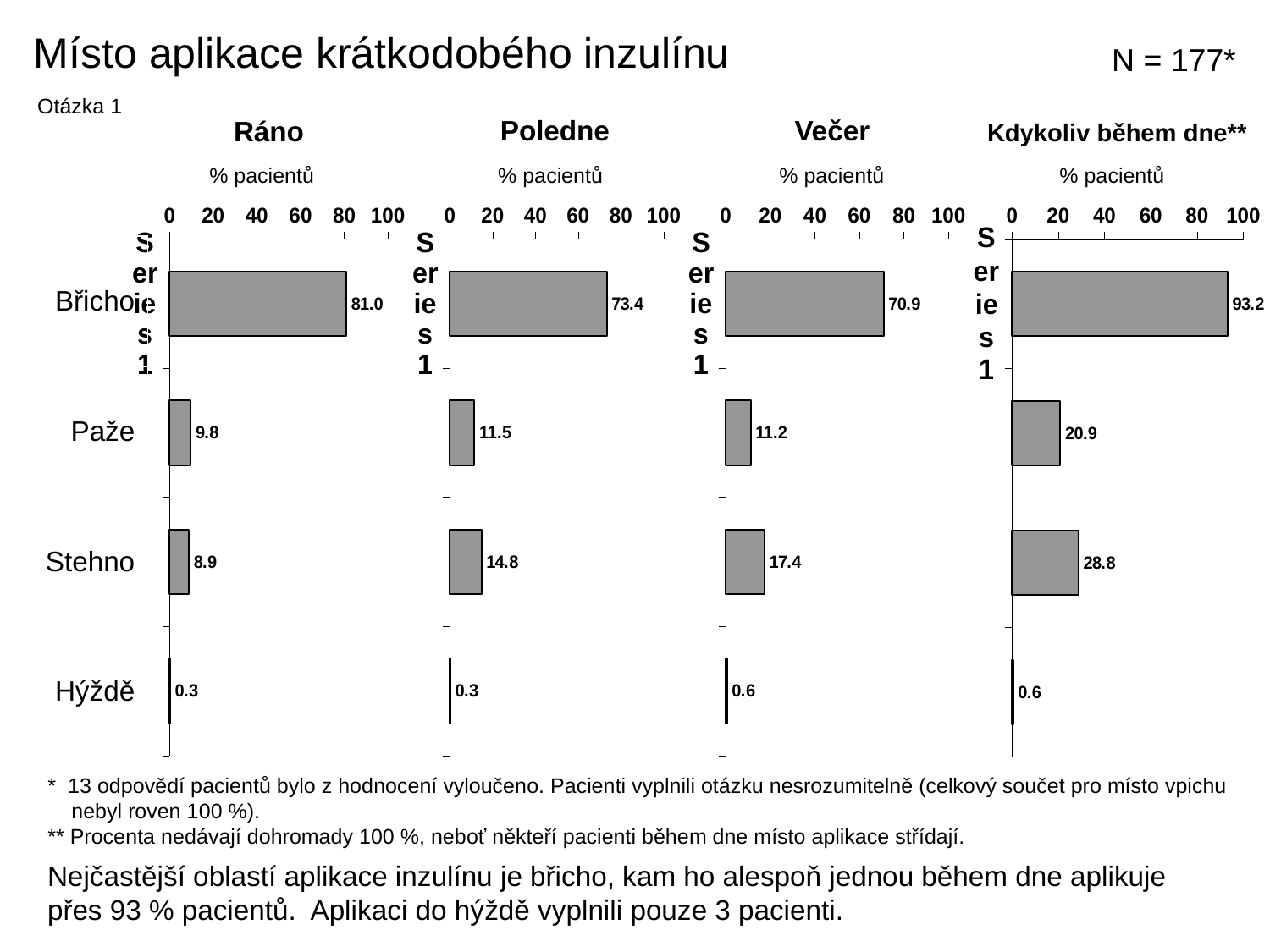
In the Poledne chart, which is larger, the value for Paže or the value for Stehno? Stehno In the Ráno chart, is the value for Břicho greater or less than 80? greater In the Kdykoliv během dne** chart, which category has the lowest value? Hýždě In the Večer chart, which category has the highest value? Břicho What kind of chart is the Poledne chart? bar chart In the Kdykoliv během dne** chart, what is the difference between the values for Stehno and Paže? 7.9 In the Ráno chart, what is the value for Břicho? 81.0 What is the x-axis label of the Večer chart? % pacientů In the Večer chart, what is the value for Paže? 11.2 In the Poledne chart, what is the value for Stehno? 14.8 In the Kdykoliv během dne** chart, what is the value for Břicho? 93.2 How many categories are shown in the Ráno chart? 4